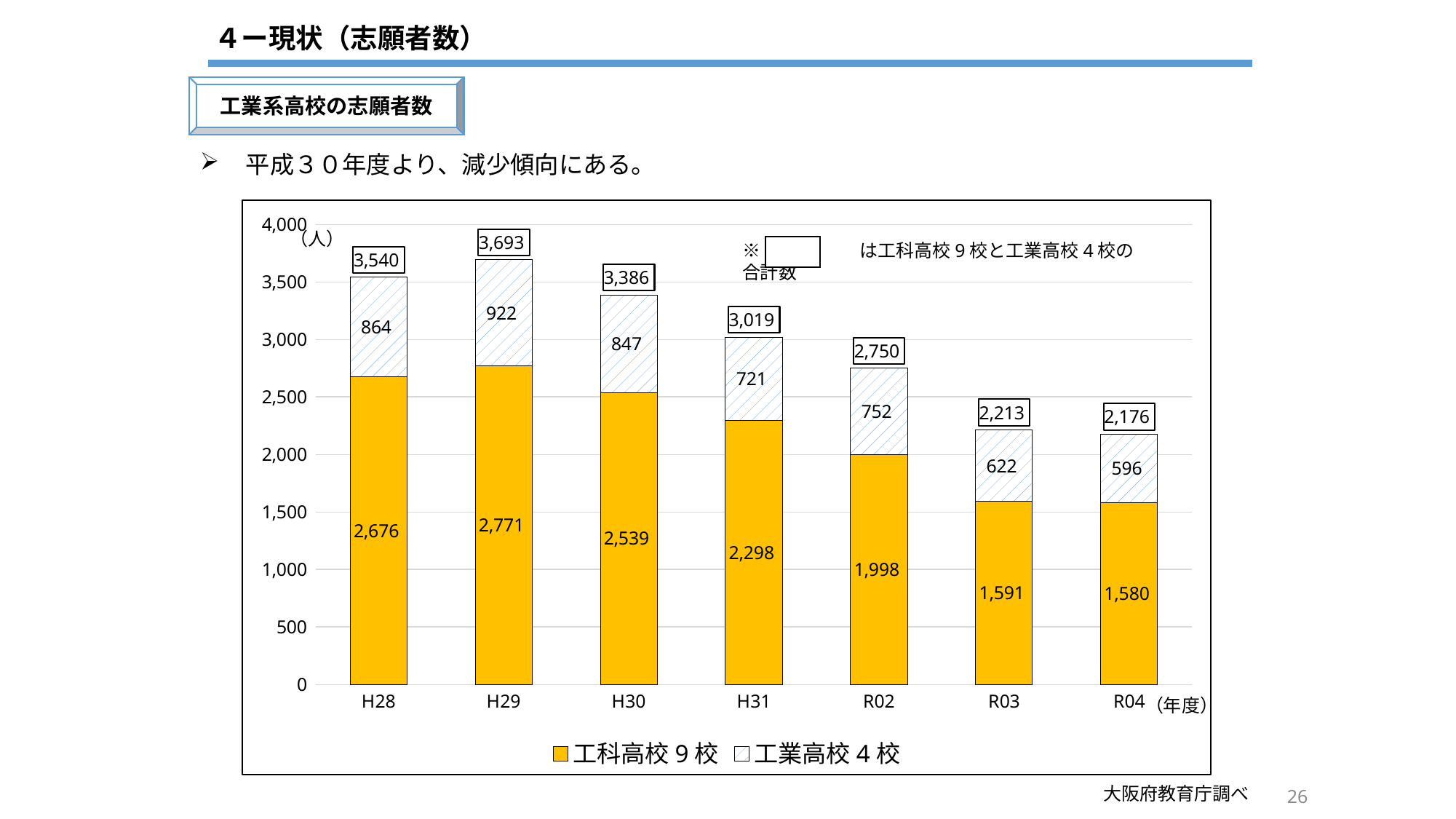
Which year has the highest total number of applicants? H29 What is the total of the stacked bar for H30? 3,386 Which year has the lowest value for 工業高校４校? R04 What is the value for 工業高校４校 in R02? 752 What kind of chart is shown on the slide? Stacked bar chart How many series does the legend list? 2 What is the value for 工科高校９校 in H29? 2,771 What is the difference between the 工業高校４校 values in H29 and R03? 300 From H30 onward, do the total values rise or fall along the x axis? Fall How many years (categories) are shown on the x axis? 7 Which is larger, the 工科高校９校 value in H31 or in R02? H31 What is the difference between the totals for H28 and R04? 1,364